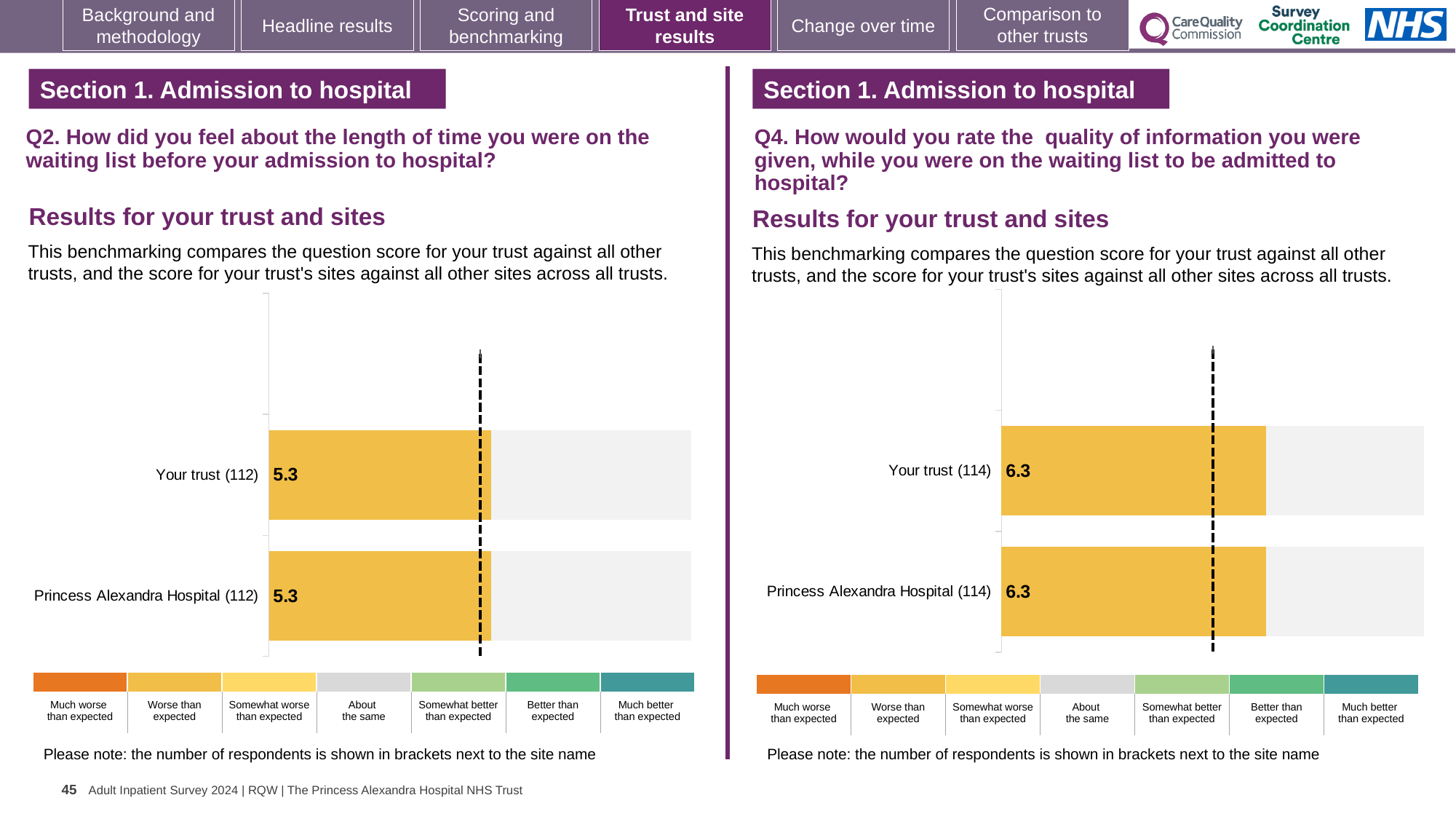
On the right chart (Q4), how many respondents are shown in brackets for Princess Alexandra Hospital? 114 How many bars are plotted on the left chart (Q2)? 2 On the left chart (Q2), what is the score for Princess Alexandra Hospital (112)? 5.3 On the left chart (Q2), how many respondents are shown in brackets for Your trust? 112 On the left chart (Q2), what is the score for Your trust (112)? 5.3 On the right chart (Q4), what is the score for Princess Alexandra Hospital (114)? 6.3 What kind of chart is used on the left (Q2) to show the results for your trust and sites? Bar chart Is the score for Your trust on the right chart (Q4) larger or smaller than the score for Your trust on the left chart (Q2)? Larger On the right chart (Q4), what is the difference between the score for Your trust and the score for Princess Alexandra Hospital? 0 On the right chart (Q4), what is the score for Your trust (114)? 6.3 On the left chart (Q2), what is the difference between the score for Your trust and the score for Princess Alexandra Hospital? 0 How many bars are plotted on the right chart (Q4)? 2